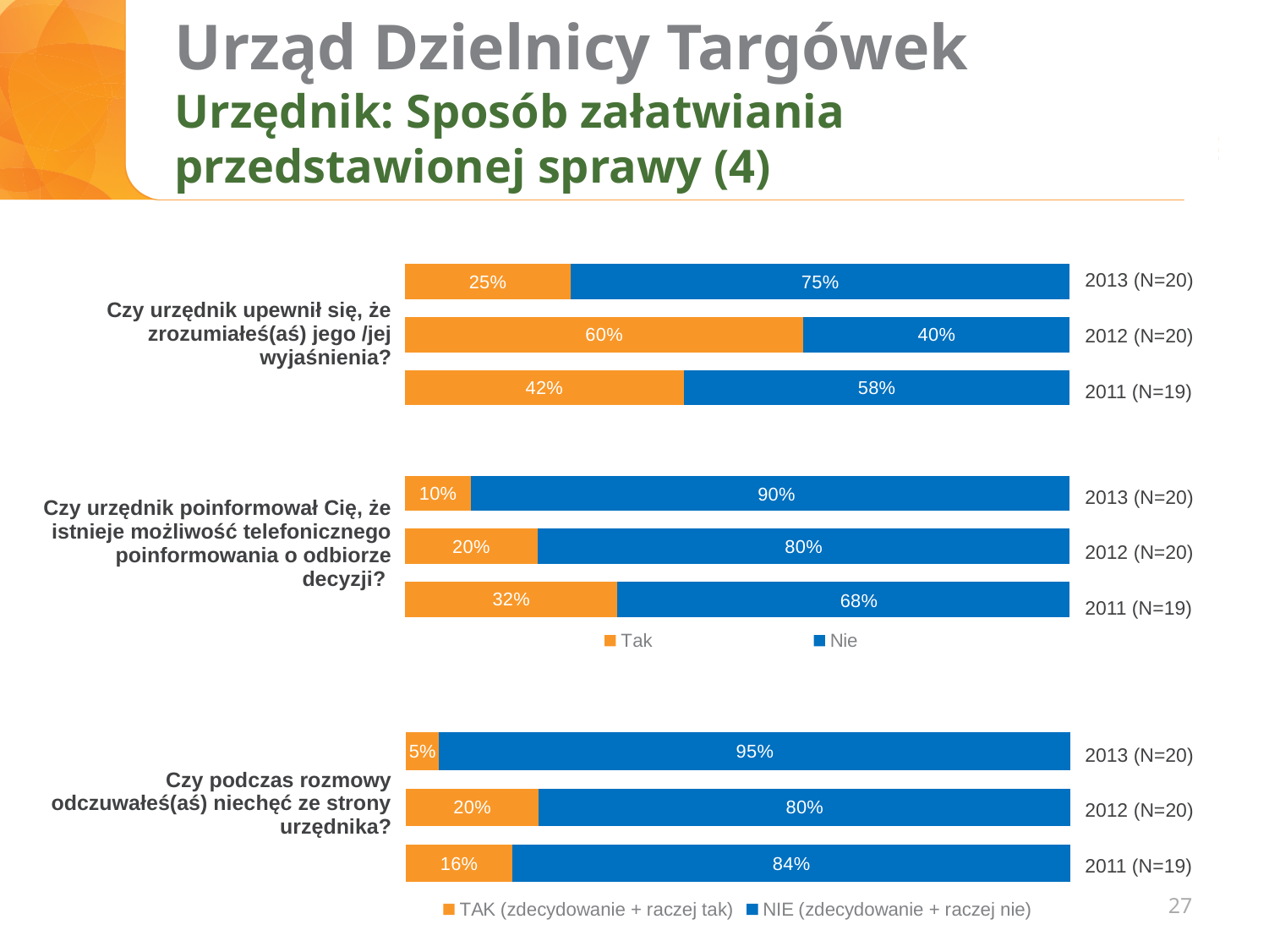
In the middle chart ("Czy urzędnik poinformował Cię, że istnieje możliwość telefonicznego poinformowania o odbiorze decyzji?"), what is the Nie value for 2013 (N=20)? 90% In the middle chart ("Czy urzędnik poinformował Cię, że istnieje możliwość telefonicznego poinformowania o odbiorze decyzji?"), how many series does the legend list? 2 In the bottom chart ("Czy podczas rozmowy odczuwałeś(aś) niechęć ze strony urzędnika?"), how many year bars are shown? 3 In the top chart ("Czy urzędnik upewnił się, że zrozumiałeś(aś) jego /jej wyjaśnienia?"), what is the difference between the Nie values for 2013 and 2011? 17 percentage points In the middle chart ("Czy urzędnik poinformował Cię, że istnieje możliwość telefonicznego poinformowania o odbiorze decyzji?"), which year has the lowest Tak share? 2013 (N=20) In the top chart ("Czy urzędnik upewnił się, że zrozumiałeś(aś) jego /jej wyjaśnienia?"), what is the Tak value for 2013 (N=20)? 25% What kind of chart is used on this slide? Stacked bar chart In the bottom chart ("Czy podczas rozmowy odczuwałeś(aś) niechęć ze strony urzędnika?"), what is the TAK value for 2013 (N=20)? 5% In the bottom chart ("Czy podczas rozmowy odczuwałeś(aś) niechęć ze strony urzędnika?"), which is larger: the TAK value for 2012 or the TAK value for 2011? 2012 In the top chart ("Czy urzędnik upewnił się, że zrozumiałeś(aś) jego /jej wyjaśnienia?"), which year has the highest Tak share? 2012 (N=20) In the bottom chart ("Czy podczas rozmowy odczuwałeś(aś) niechęć ze strony urzędnika?"), what is the NIE value for 2011 (N=19)? 84% In the top chart ("Czy urzędnik upewnił się, że zrozumiałeś(aś) jego /jej wyjaśnienia?"), what is the Nie value for 2012 (N=20)? 40%